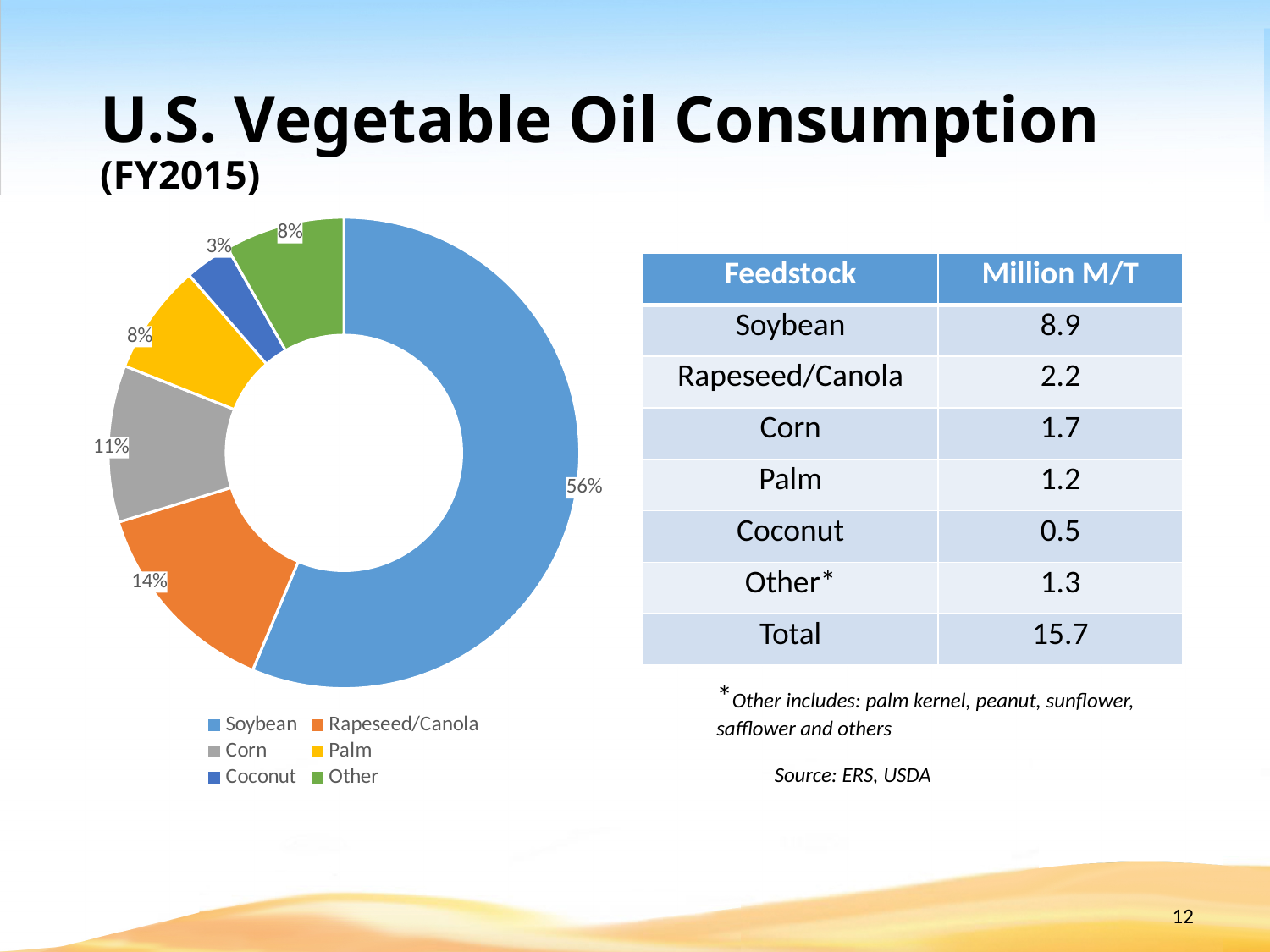
Which has a larger share in the chart, Corn or Palm? Corn Which feedstock has the smallest share in the chart? Coconut What percentage share does Coconut have in the chart? 3% What is the difference in percentage points between the Palm share and the Coconut share? 5 What percentage share does Soybean have in the chart? 56% How many categories does the chart's legend list? 6 What is the difference in percentage points between the Soybean share and the Rapeseed/Canola share? 42 What percentage share does Corn have in the chart? 11% What colour is the Rapeseed/Canola slice in the chart? Orange What kind of chart is shown on the slide? Doughnut (pie) chart What percentage share does Rapeseed/Canola have in the chart? 14% Which feedstock has the largest share in the chart? Soybean